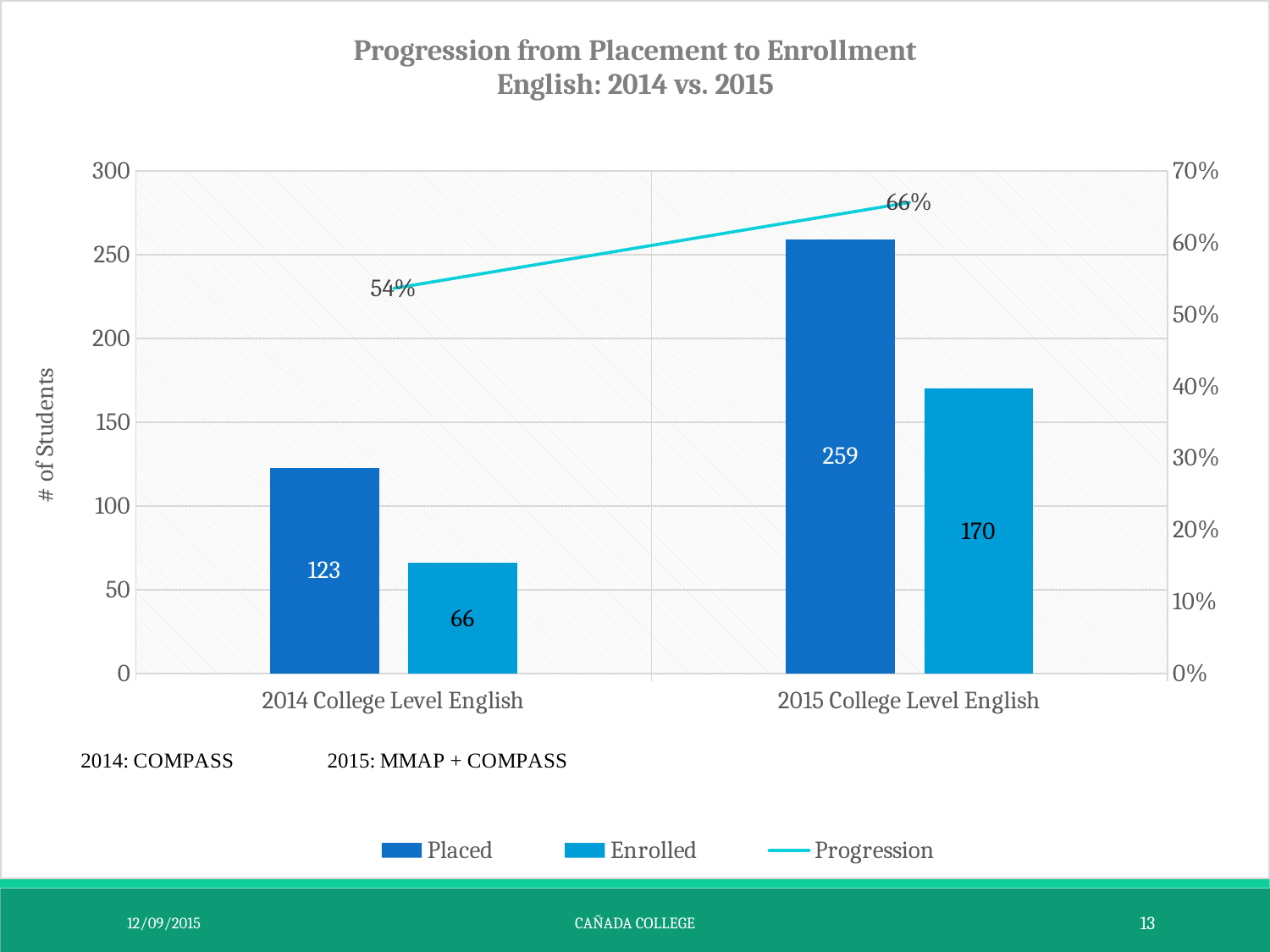
How many students were Enrolled in 2015 College Level English? 170 Which category has the higher number of Placed students? 2015 College Level English What is the label of the left vertical axis? # of Students What is the difference between Placed and Enrolled students in 2014 College Level English? 57 Is the number of Enrolled students in 2015 College Level English greater or less than 150? greater Does the Progression line rise or fall from 2014 to 2015? rise What is the Progression percentage for 2014 College Level English? 54% What is the Progression percentage for 2015 College Level English? 66% What is the difference between the number of Placed students in 2015 and in 2014? 136 How many series does the legend list? 3 How many categories are shown on the x axis? 2 How many students were Placed in 2014 College Level English? 123